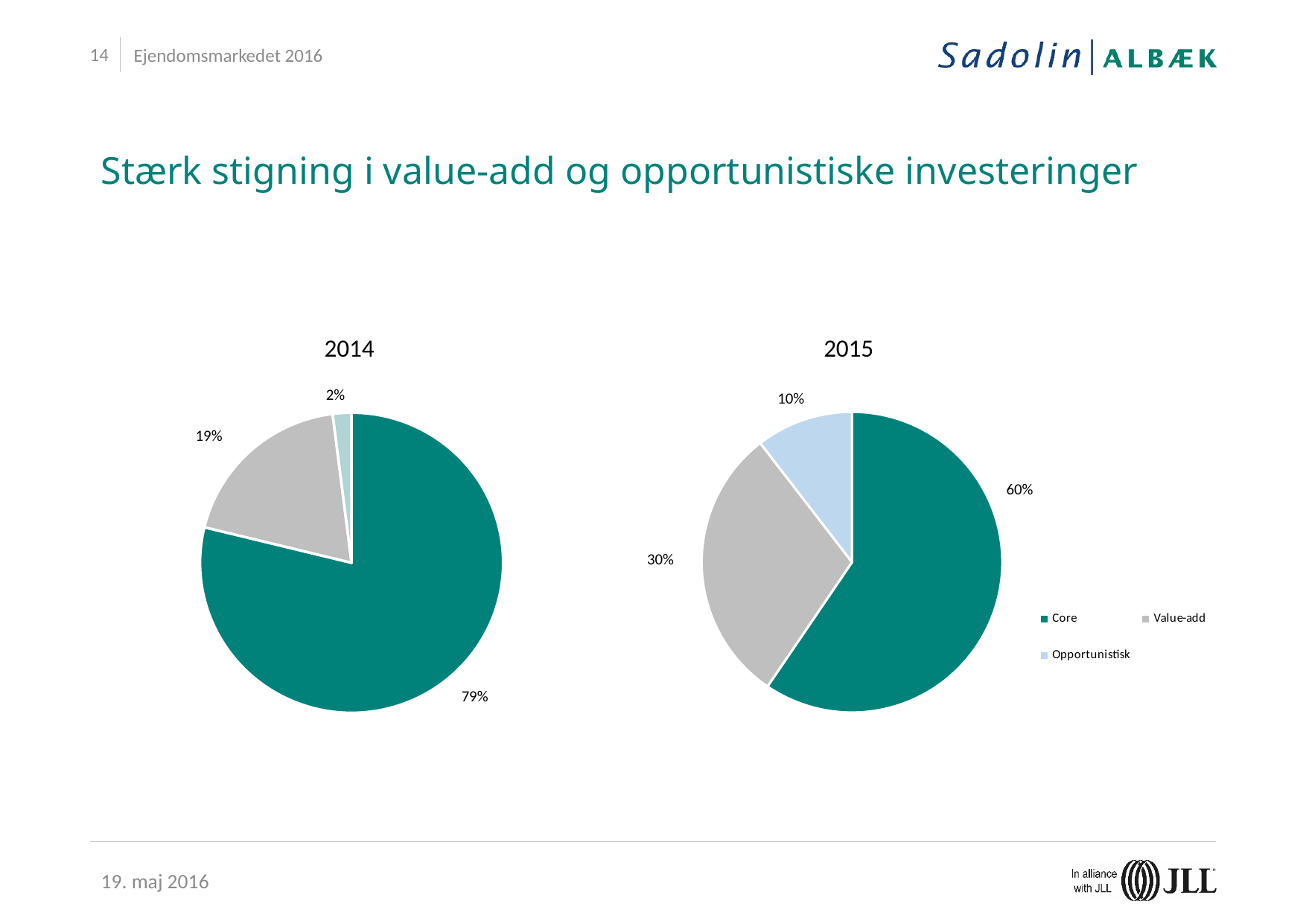
In the 2014 pie chart, what share does Core have? 79% In the 2014 pie chart, which category has the smallest slice? Opportunistisk Is the Value-add share larger in the 2014 chart or the 2015 chart? 2015 In the 2015 pie chart, what share does Value-add have? 30% In the 2015 pie chart, which category has the largest slice? Core In the 2014 pie chart, what share does Value-add have? 19% What is the difference between the Core share in 2014 and the Core share in 2015? 19 percentage points In the 2015 pie chart, what share does Opportunistisk have? 10% What type of chart is used for the 2014 and 2015 data? Pie chart How many categories does the legend list? 3 How many slices does the 2015 pie chart have? 3 What is the title of the slide? Stærk stigning i value-add og opportunistiske investeringer